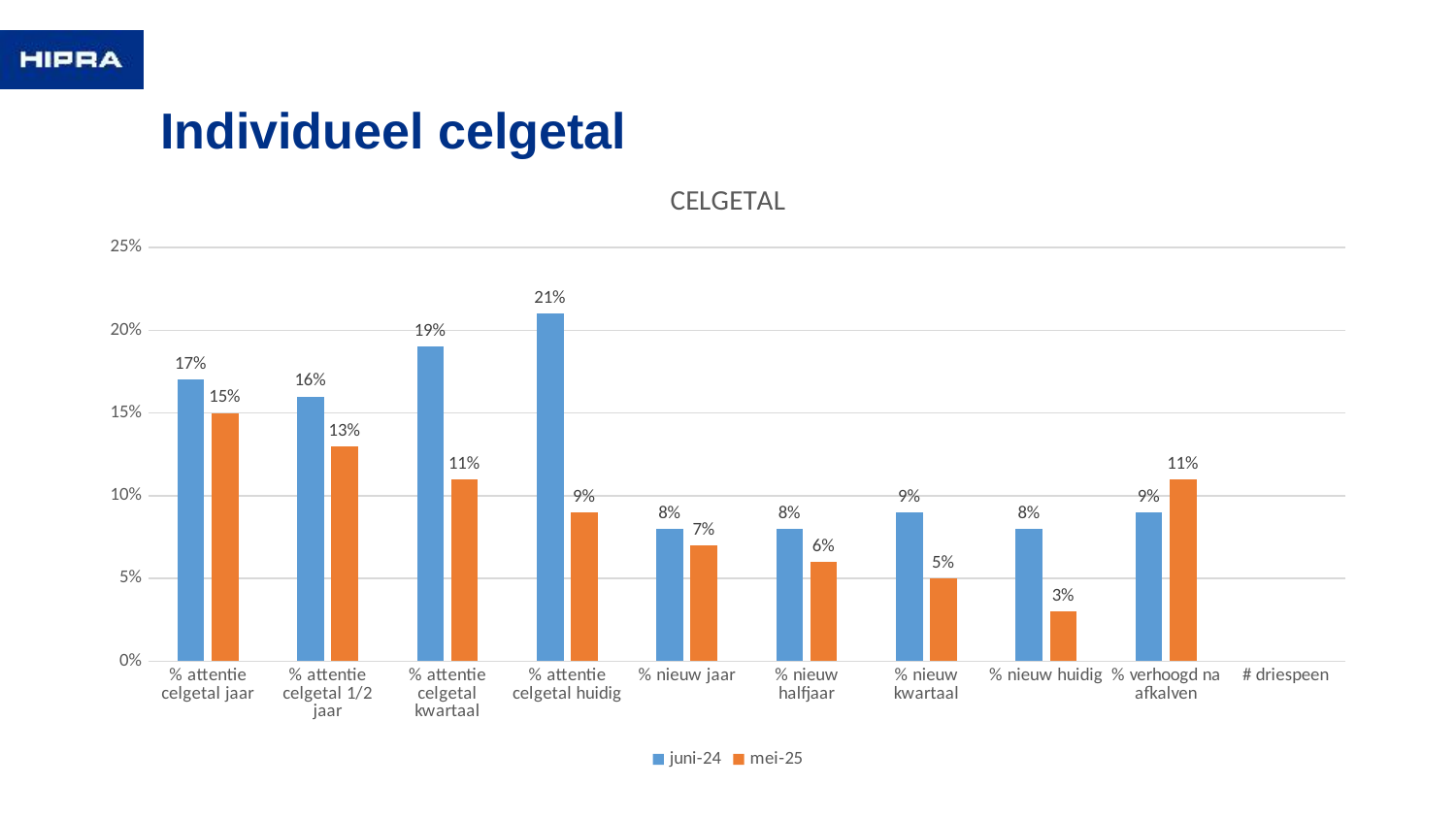
What is the mei-25 value for % nieuw huidig? 3% What is the mei-25 value for % attentie celgetal kwartaal? 11% For % verhoogd na afkalven, which is larger: the juni-24 value or the mei-25 value? mei-25 What is the juni-24 value for % attentie celgetal huidig? 21% What is the title of the chart? CELGETAL How many series does the legend list? 2 Which category has the lowest mei-25 value? % nieuw huidig Which category has the highest juni-24 value? % attentie celgetal huidig What is the difference between the juni-24 and mei-25 values for % attentie celgetal huidig? 12% What is the difference between the juni-24 and mei-25 values for % attentie celgetal jaar? 2% Is the juni-24 value for % attentie celgetal kwartaal greater or less than 15%? greater What kind of chart is shown on the slide? bar chart